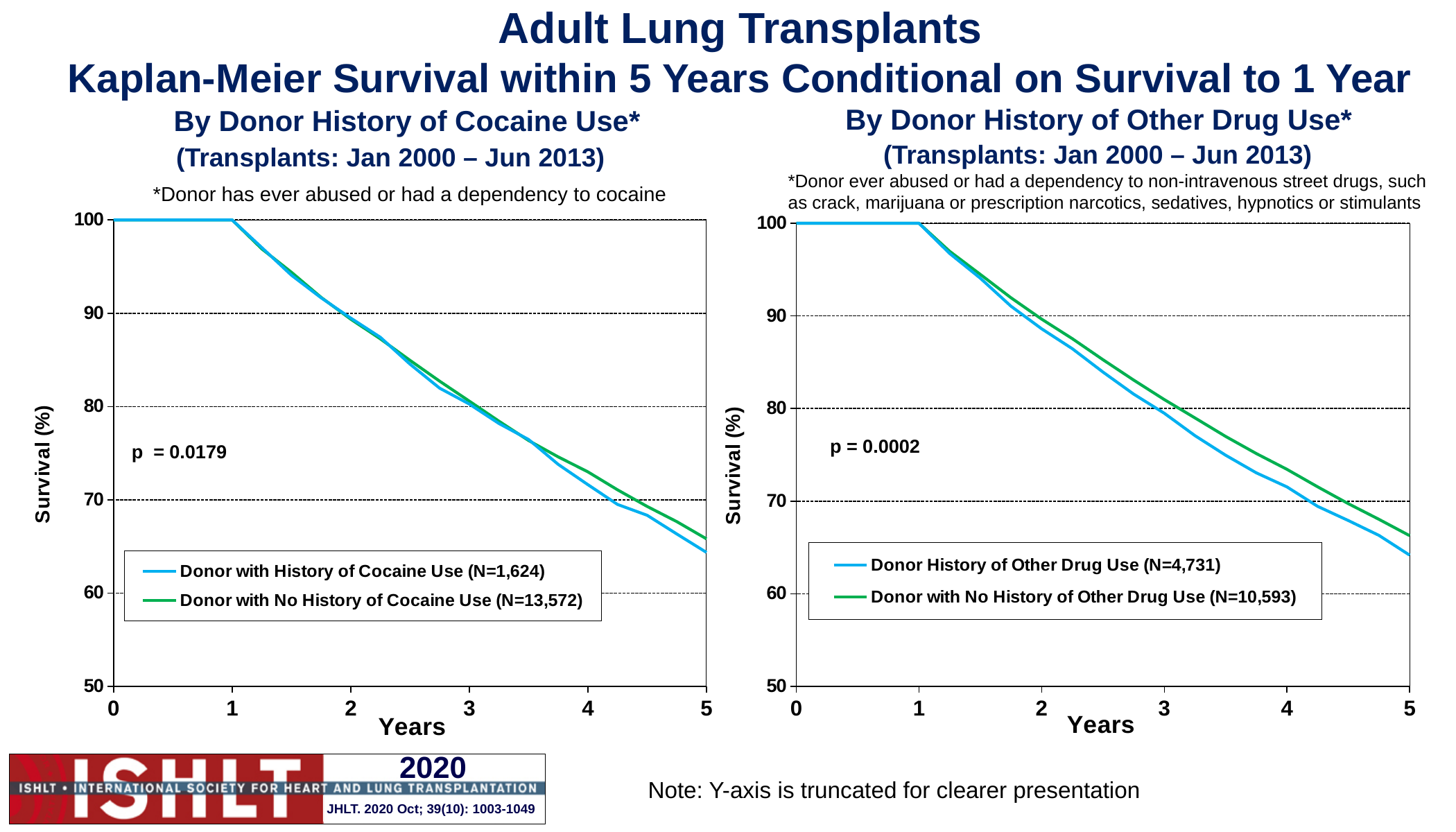
In the right chart, 'By Donor History of Other Drug Use', what is the survival (%) for both groups at year 0? 100 In the right chart, 'By Donor History of Other Drug Use', is the survival for donors with no history of other drug use at year 4 greater or less than 70? greater How many series does the legend of the right chart, 'By Donor History of Other Drug Use', list? 2 In the left chart, 'By Donor History of Cocaine Use', what is the N for the 'Donor with History of Cocaine Use' series in the legend? N=1,624 In the right chart, 'By Donor History of Other Drug Use', which group has higher survival at year 4? Donor with No History of Other Drug Use What p-value is shown on the right chart, 'By Donor History of Other Drug Use'? p = 0.0002 In the right chart, 'By Donor History of Other Drug Use', is the survival for donors with a history of other drug use at year 5 greater or less than 70? less What kind of chart is the left chart, 'By Donor History of Cocaine Use'? Line chart In the left chart, 'By Donor History of Cocaine Use', which group has higher survival at year 5? Donor with No History of Cocaine Use In the left chart, 'By Donor History of Cocaine Use', what is the survival (%) for both groups at year 1? 100 In the left chart, 'By Donor History of Cocaine Use', is the survival for donors with a history of cocaine use at year 5 greater or less than 70? less In the left chart, 'By Donor History of Cocaine Use', do the survival curves rise or fall as years increase from 1 to 5? Fall